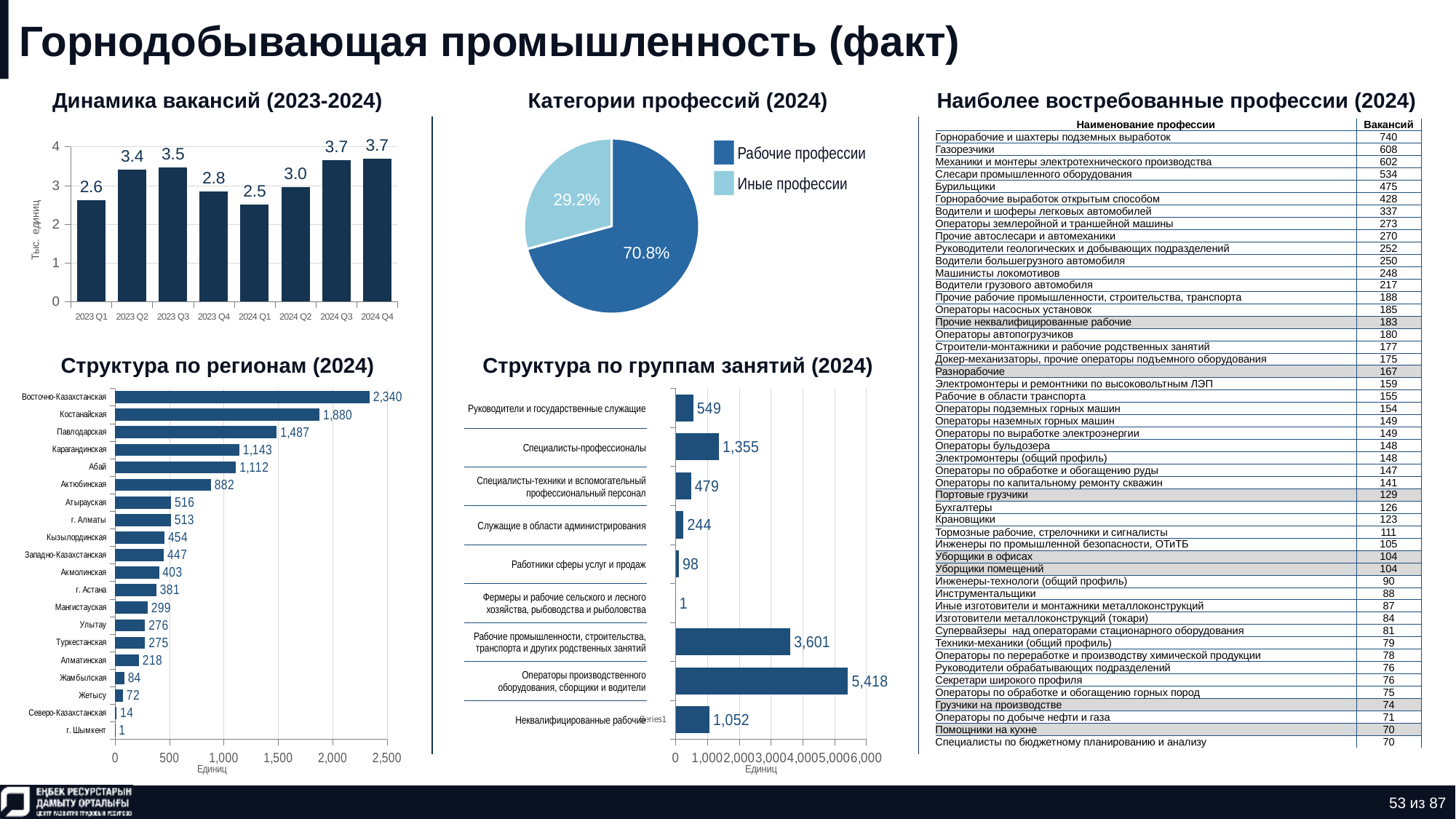
In the chart 'Динамика вакансий (2023-2024)', how many quarters are plotted? 8 In the chart 'Категории профессий (2024)', what share of the pie is 'Иные профессии'? 29.2% In the chart 'Структура по группам занятий (2024)', what is the difference between the values for 'Операторы производственного оборудования, сборщики и водители' and 'Рабочие промышленности, строительства, транспорта и других родственных занятий'? 1,817 In the chart 'Структура по регионам (2024)', which is larger, the value for Атырауская or the value for г. Астана? Атырауская In the chart 'Динамика вакансий (2023-2024)', what is the value for 2023 Q1? 2.6 What kind of chart is 'Категории профессий (2024)'? Pie chart In the chart 'Структура по регионам (2024)', which region has the highest value? Восточно-Казахстанская In the chart 'Структура по регионам (2024)', what is the value for Костанайская? 1,880 In the chart 'Динамика вакансий (2023-2024)', what is the difference between the values for 2024 Q3 and 2024 Q1? 1.2 In the chart 'Структура по группам занятий (2024)', which group has the highest value? Операторы производственного оборудования, сборщики и водители In the chart 'Структура по группам занятий (2024)', what is the value for 'Специалисты-профессионалы'? 1,355 In the chart 'Динамика вакансий (2023-2024)', which quarter has the lowest value? 2024 Q1